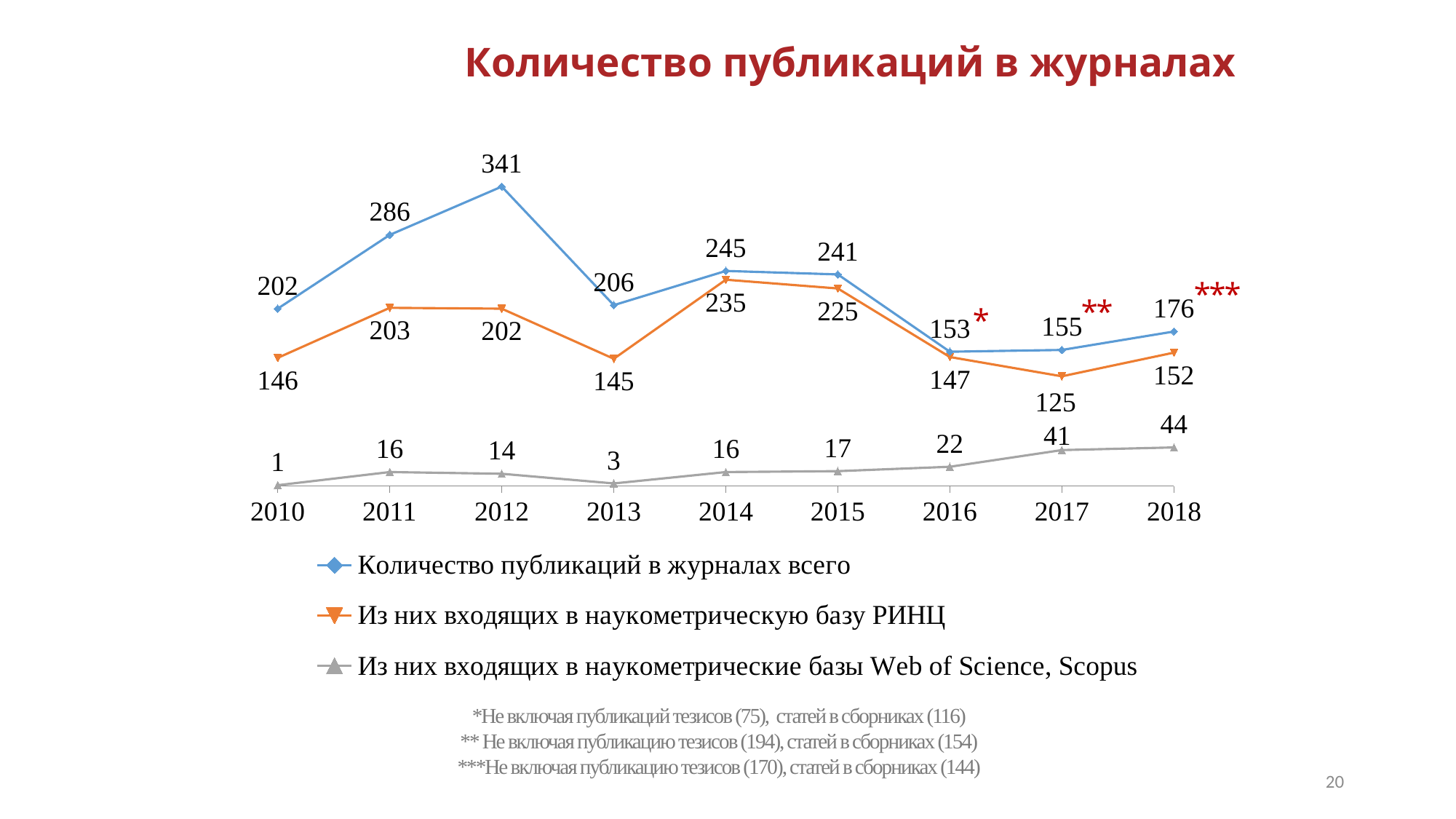
Which is larger: 'Количество публикаций в журналах всего' in 2011 or in 2015? 2011 What type of chart is shown on the slide? line chart What is the value of 'Из них входящих в наукометрическую базу РИНЦ' in 2014? 235 How many years are shown on the x axis? 9 What is the value of 'Из них входящих в наукометрические базы Web of Science, Scopus' in 2017? 41 What is the title of the chart? Количество публикаций в журналах In which year is 'Из них входящих в наукометрические базы Web of Science, Scopus' lowest? 2010 Does 'Из них входящих в наукометрические базы Web of Science, Scopus' rise or fall from 2015 to 2018? rise In which year is 'Количество публикаций в журналах всего' highest? 2012 What is the difference between 'Количество публикаций в журналах всего' and 'Из них входящих в наукометрическую базу РИНЦ' in 2017? 30 How many series does the legend list? 3 What is the value of 'Количество публикаций в журналах всего' in 2012? 341